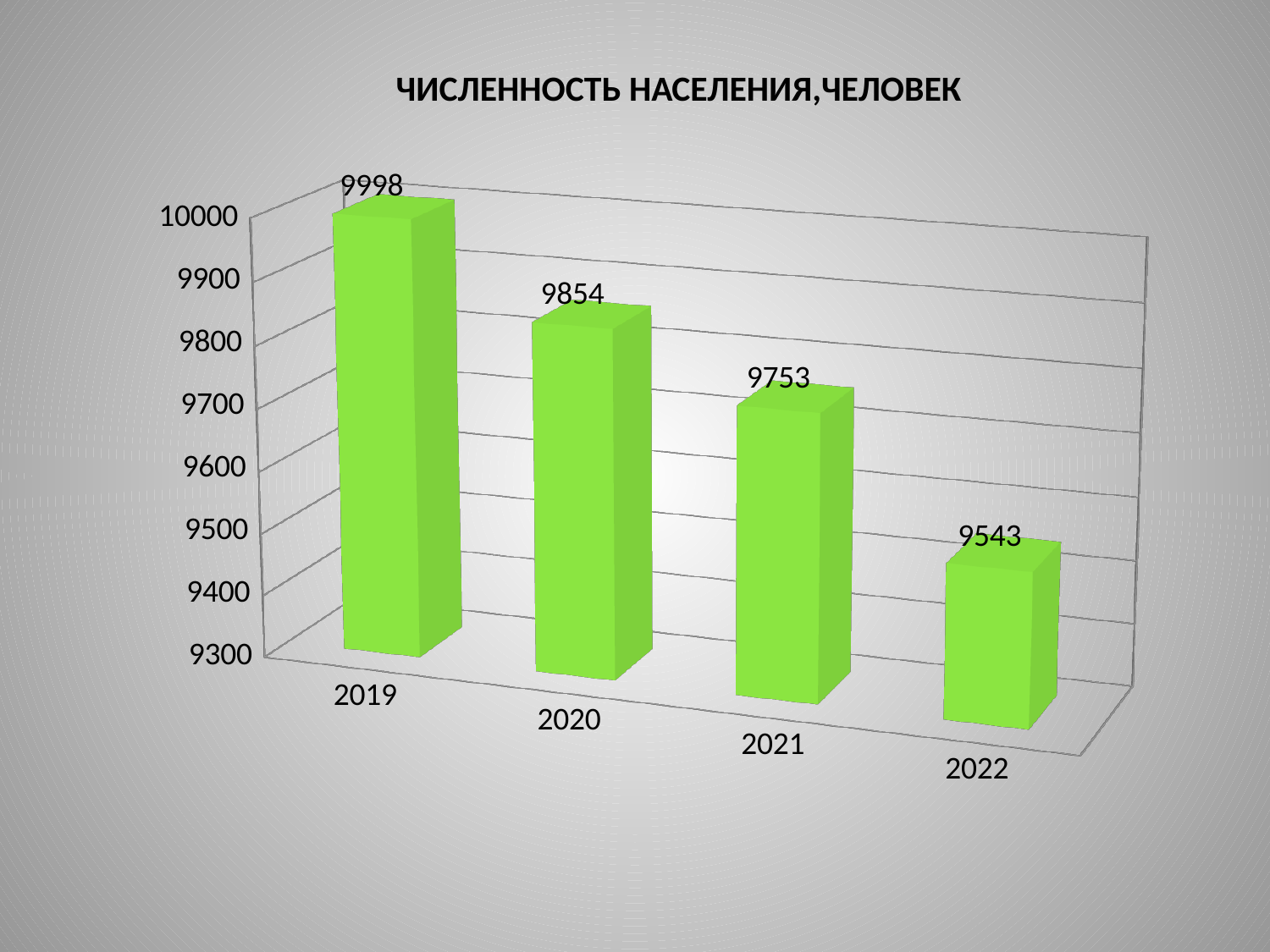
Which year has a larger population value, 2020 or 2021? 2020 How many years are shown on the chart? 4 What is the population value shown for 2021? 9753 Do the population values rise or fall from 2019 to 2022? fall What is the difference between the population values for 2019 and 2022? 455 What is the population value shown for 2020? 9854 What is the population value shown for 2022? 9543 What is the population value shown for 2019? 9998 What is the difference between the population values for 2020 and 2021? 101 What kind of chart is shown on the slide? bar chart Which year has the lowest population value? 2022 Which year has the highest population value? 2019